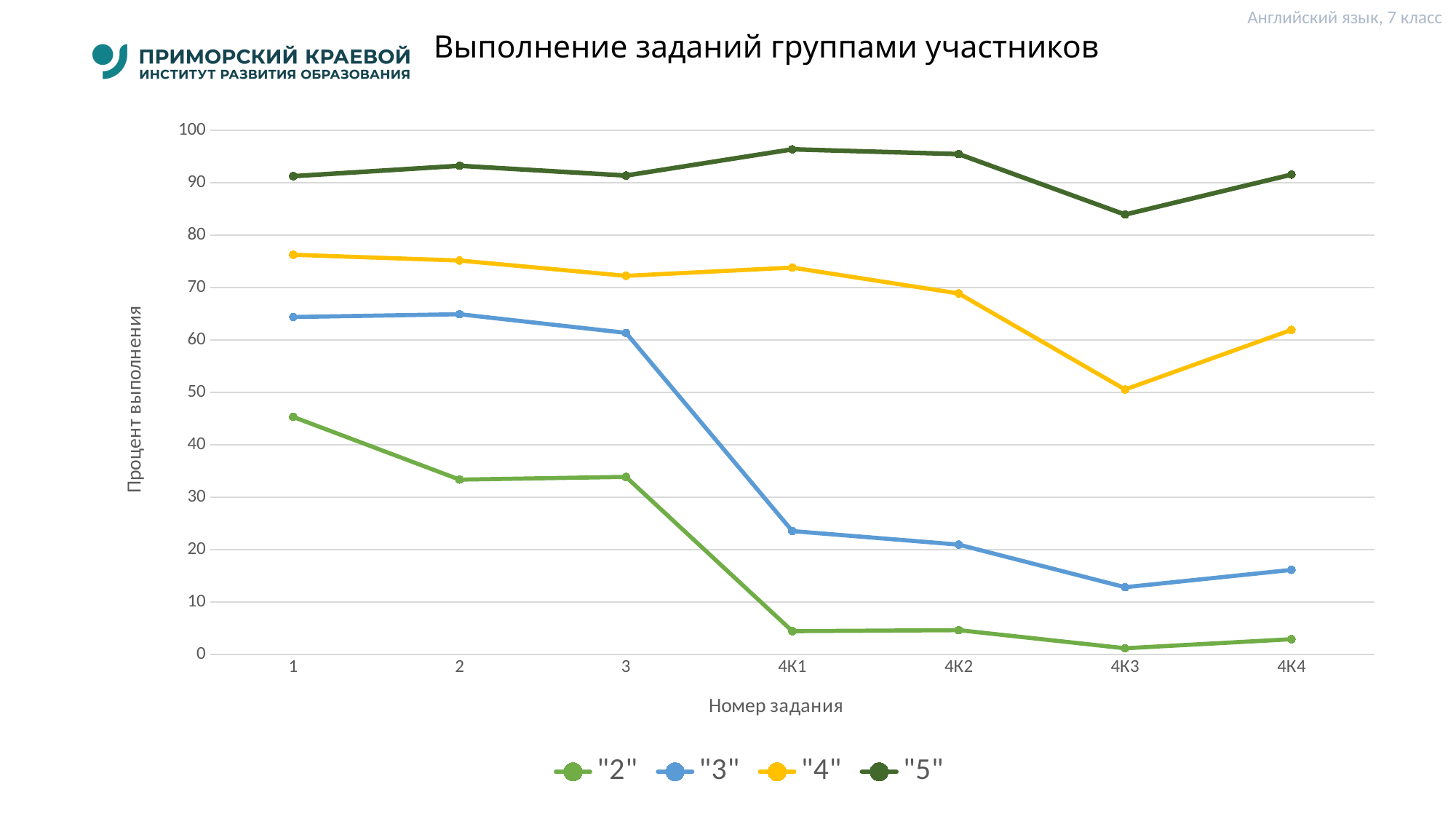
How many task numbers are shown along the x axis? 7 What kind of chart is shown on the slide? line chart How many series does the legend list? 4 Is the value for series "2" at task 4К1 greater or less than 10? less For series "2", at which task is the value highest? 1 Is the value for series "5" at task 4К3 greater or less than 80? greater Which series has the highest value at task 4К1? "5" Which is larger for series "4": the value at task 1 or the value at task 4К3? task 1 For series "4", at which task is the value lowest? 4К3 For series "5", at which task is the value lowest? 4К3 What is the title of the y axis? Процент выполнения Is the value for series "3" at task 4К1 greater or less than 20? greater